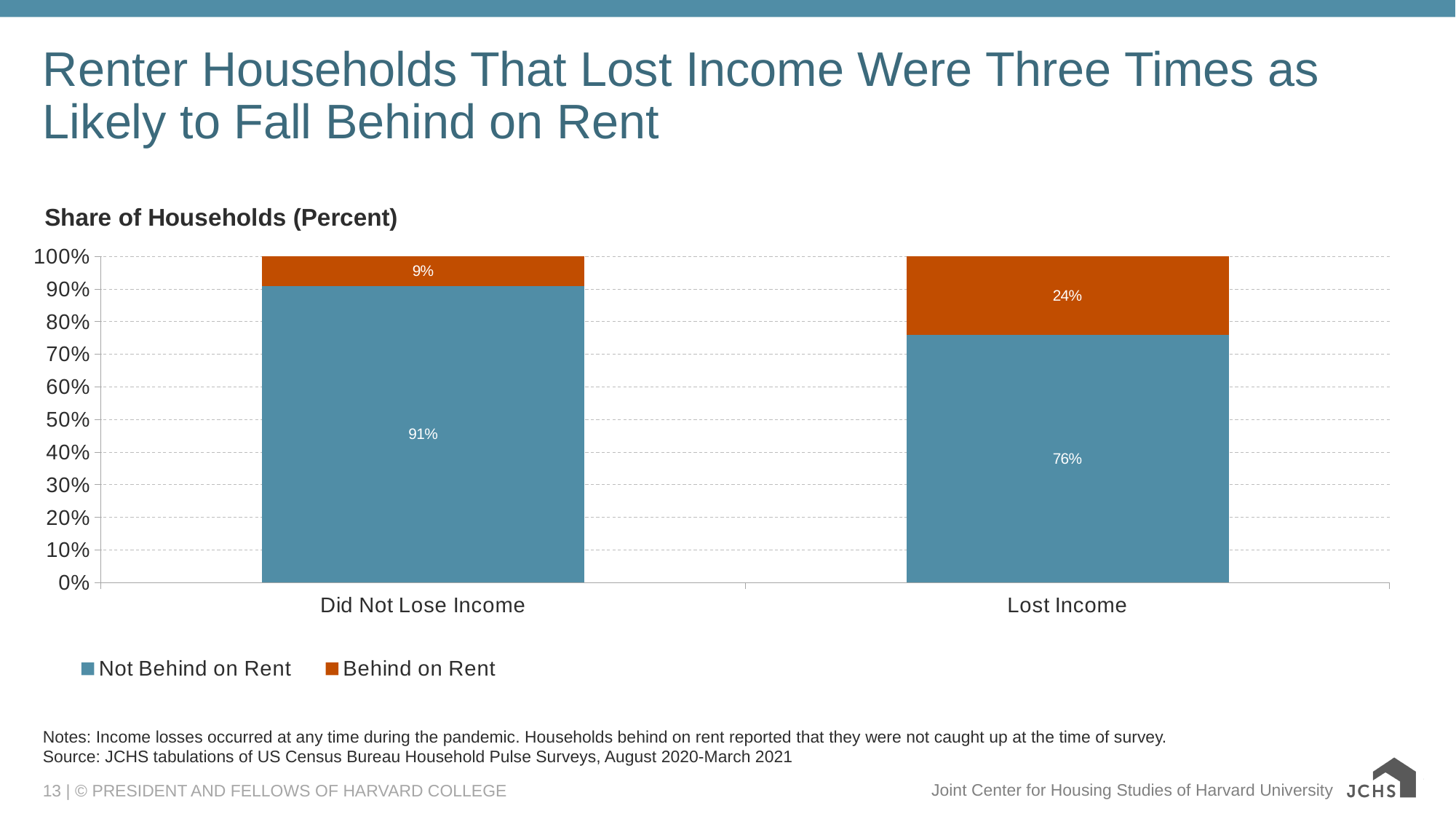
What share of households that lost income were not behind on rent? 76% What is the total of the stacked bar for Lost Income? 100% How many series does the legend list? 2 Which category has the lower share of households not behind on rent? Lost Income What share of households that did not lose income were behind on rent? 9% What kind of chart is shown on the slide? Stacked bar chart How many categories are shown on the x axis? 2 What is the difference in the share behind on rent between Lost Income and Did Not Lose Income households? 15 percentage points What share of households that lost income were behind on rent? 24% What share of households that did not lose income were not behind on rent? 91% Is the share of Not Behind on Rent larger for Did Not Lose Income or Lost Income? Did Not Lose Income Which category has the higher share of households behind on rent? Lost Income